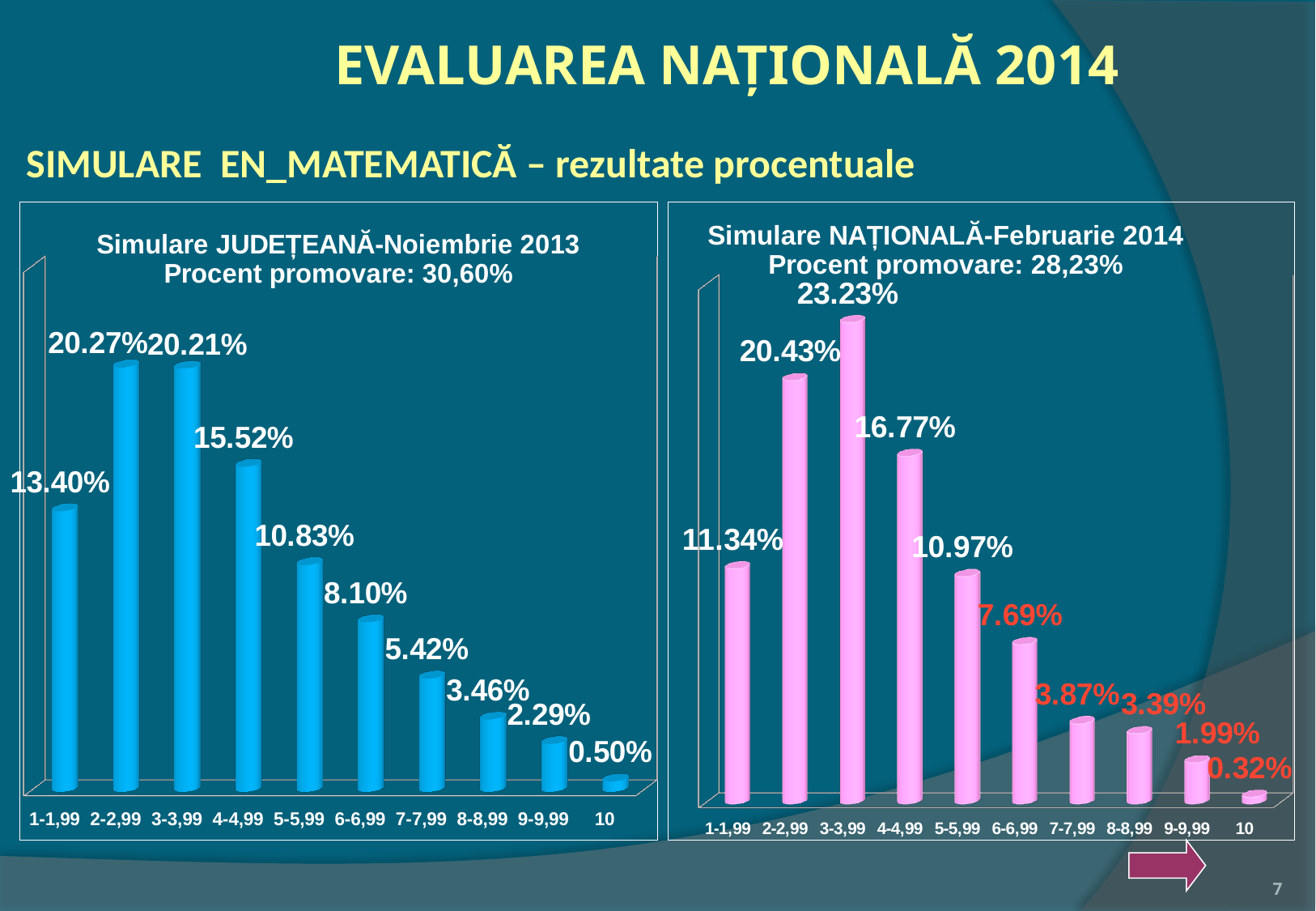
In the left chart (Simulare JUDEȚEANĂ-Noiembrie 2013), which category has the lowest value? 10 What kind of chart is the right chart (Simulare NAȚIONALĂ-Februarie 2014)? Bar chart In the left chart (Simulare JUDEȚEANĂ-Noiembrie 2013), what is the difference between the values for 1-1,99 and 6-6,99? 5.30% In the right chart (Simulare NAȚIONALĂ-Februarie 2014), what is the value for the 10 category? 0.32% In the right chart (Simulare NAȚIONALĂ-Februarie 2014), which category has the highest value? 3-3,99 Which is larger: the value for 5-5,99 in the left chart or the value for 5-5,99 in the right chart? The right chart (10.97%) What pass rate (procent promovare) is stated in the title of the left chart? 30,60% In the left chart (Simulare JUDEȚEANĂ-Noiembrie 2013), what is the value for the 4-4,99 category? 15.52% In the right chart (Simulare NAȚIONALĂ-Februarie 2014), what is the value for the 3-3,99 category? 23.23% In the right chart (Simulare NAȚIONALĂ-Februarie 2014), what is the difference between the values for 2-2,99 and 4-4,99? 3.66% In the right chart (Simulare NAȚIONALĂ-Februarie 2014), is the value for 1-1,99 larger or smaller than the value for 2-2,99? smaller How many categories are shown on the x axis of the left chart (Simulare JUDEȚEANĂ-Noiembrie 2013)? 10